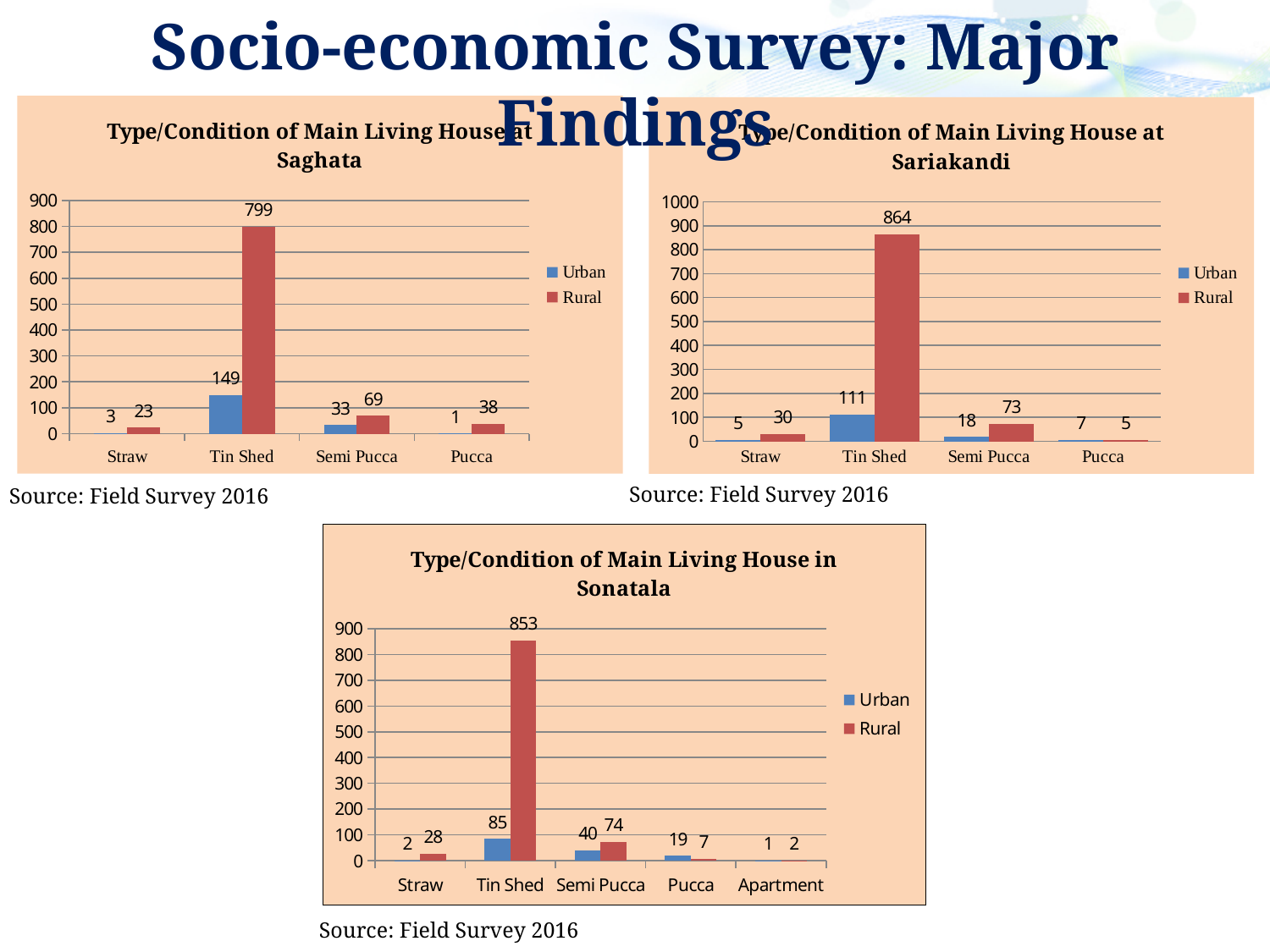
In the Sariakandi chart, what is the Rural value for Tin Shed? 864 What type of chart is the Sariakandi chart? Bar chart In the Sonatala chart, which category has the highest Rural value? Tin Shed In the Sariakandi chart, what is the difference between the Rural and Urban values for Tin Shed? 753 In the Sonatala chart, what is the Rural value for Semi Pucca? 74 In the Sariakandi chart, what is the Urban value for Pucca? 7 How many series does the legend of the Saghata chart list? 2 In the Sonatala chart, which is larger for Pucca, the Urban value or the Rural value? Urban In the Saghata chart, which category has the lowest Urban value? Pucca In the Saghata chart, what is the Urban value for Semi Pucca? 33 How many categories are shown on the x axis of the Sonatala chart? 5 In the Saghata chart, what is the Rural value for Tin Shed? 799